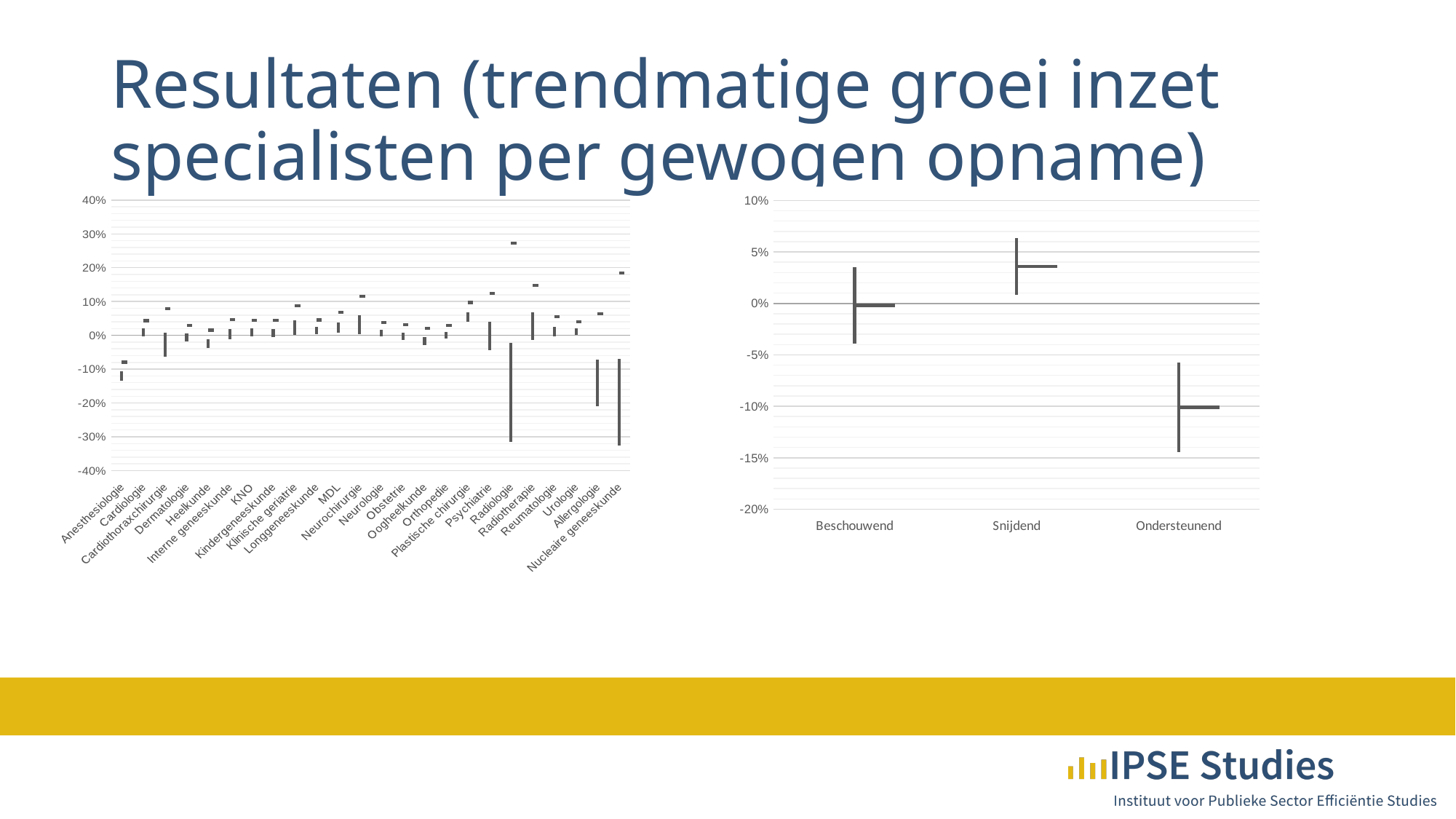
In the right chart, which is larger, the value for Snijdend or the value for Ondersteunend? Snijdend How many categories are shown on the x axis of the right chart? 3 In the left chart, is the value for Cardiothoraxchirurgie greater or less than 10%? less In the right chart, which category has the lowest value? Ondersteunend In the right chart, which category has the highest value? Snijdend In the left chart, is the value for Anesthesiologie greater or less than 0%? less In the left chart, which specialty has the highest marked value? Radiologie In the right chart, is the value for Ondersteunend greater or less than -5%? less How many specialties are shown on the x axis of the left chart? 24 What is the range of the y axis in the right chart? -20% to 10%